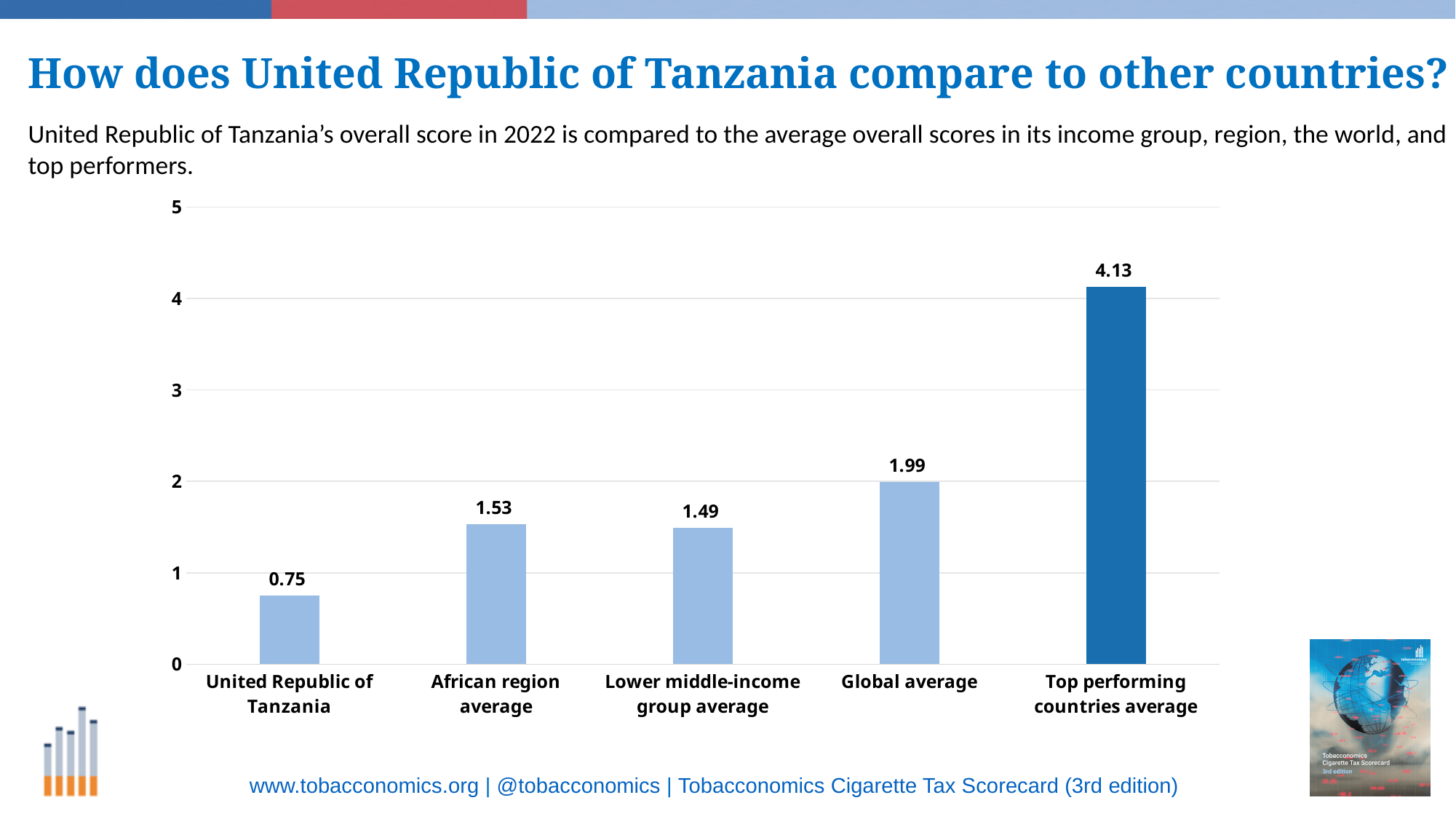
Which is larger, the African region average or the Lower middle-income group average? African region average What is the value for the Global average? 1.99 What kind of chart is shown on the slide? Bar chart How many categories are shown on the chart? 5 What is the value for the Top performing countries average? 4.13 What is the value for the Lower middle-income group average? 1.49 Which category has the lowest value? United Republic of Tanzania Which category has the highest value? Top performing countries average What is the value for the African region average? 1.53 What is the difference between the Top performing countries average and United Republic of Tanzania's score? 3.38 What is the overall score for United Republic of Tanzania? 0.75 What is the difference between the Global average and the African region average? 0.46